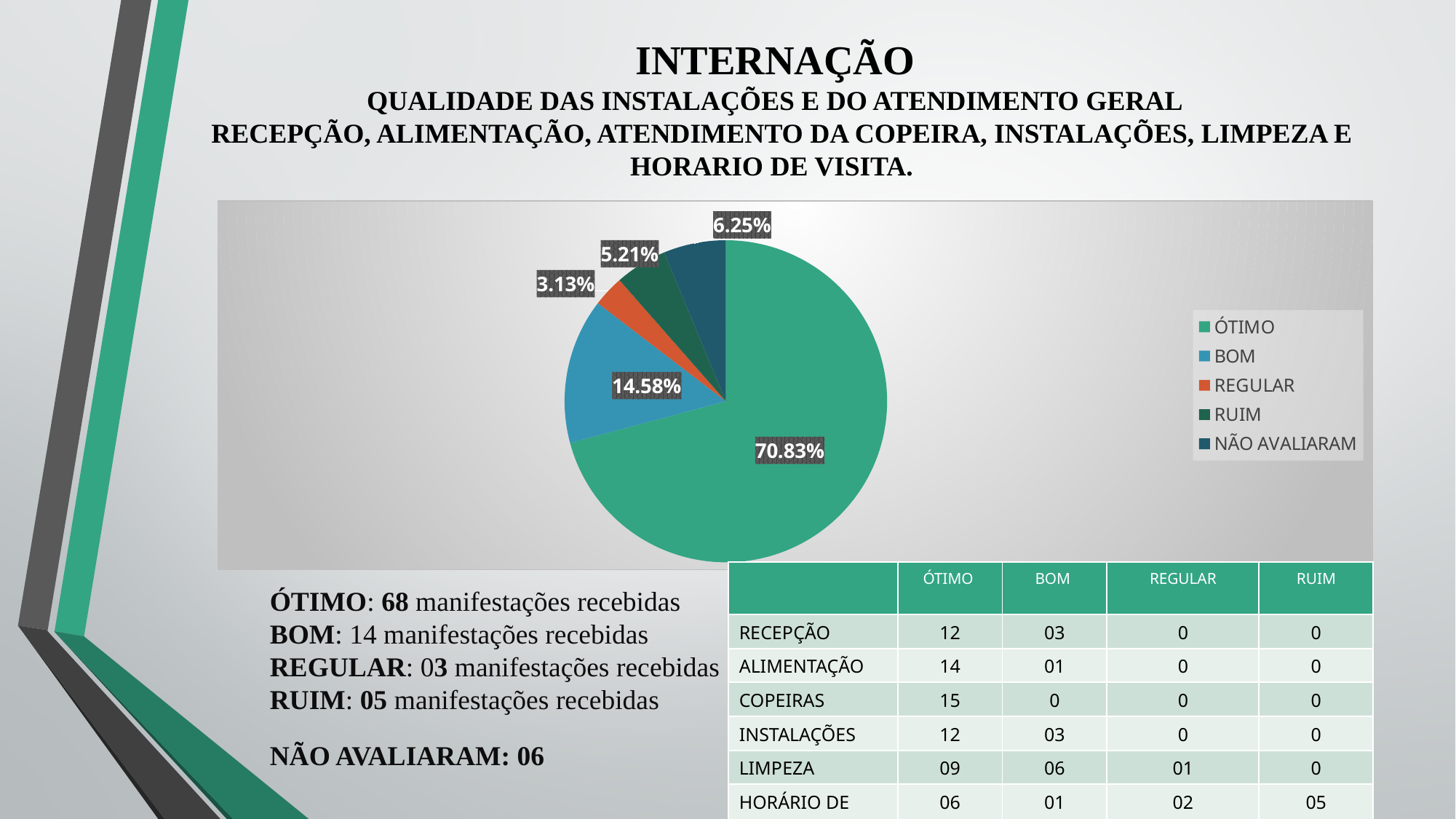
What percentage does the BOM slice show in the pie chart? 14.58% What kind of chart is shown on the slide? pie chart What percentage of the pie chart is labelled for ÓTIMO? 70.83% How many slices does the pie chart have? 5 What percentage is shown for the REGULAR slice? 3.13% What percentage is shown for the RUIM slice? 5.21% Which category has the smallest slice of the pie chart? REGULAR Which category has the largest slice of the pie chart? ÓTIMO Which slice is larger, RUIM or NÃO AVALIARAM? NÃO AVALIARAM How many entries does the pie chart legend list? 5 What is the difference in percentage points between the ÓTIMO and BOM slices? 56.25 What percentage is shown for NÃO AVALIARAM in the pie chart? 6.25%